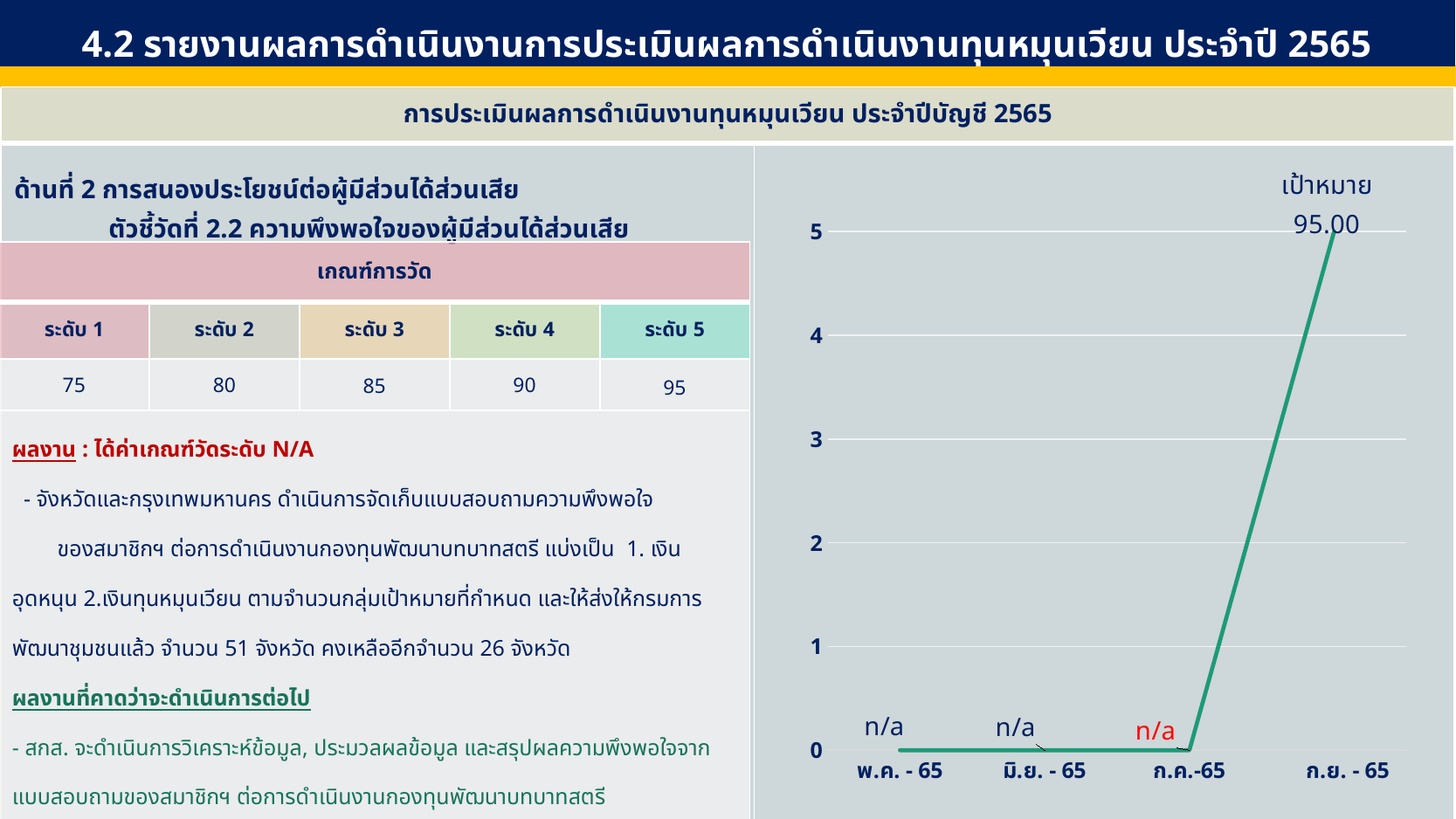
Which is larger on the line chart, the value for ก.ย. - 65 or the value for ก.ค.-65? ก.ย. - 65 Which category has the highest point on the line chart? ก.ย. - 65 What target value (เป้าหมาย) is labelled at the last point of the line chart? 95.00 How many categories are shown on the x axis of the line chart? 4 What data label is shown for พ.ค. - 65 in the line chart? n/a Is the value for ก.ค.-65 on the line chart greater or less than 1? less Does the line rise or fall between ก.ค.-65 and ก.ย. - 65? rises What data label is shown for มิ.ย. - 65 in the line chart? n/a What is the highest tick value shown on the y axis of the line chart? 5 What data label is shown for ก.ค.-65 in the line chart? n/a What kind of chart is shown on the right side of the slide? line chart Is the value for ก.ย. - 65 on the line chart greater or less than 4? greater